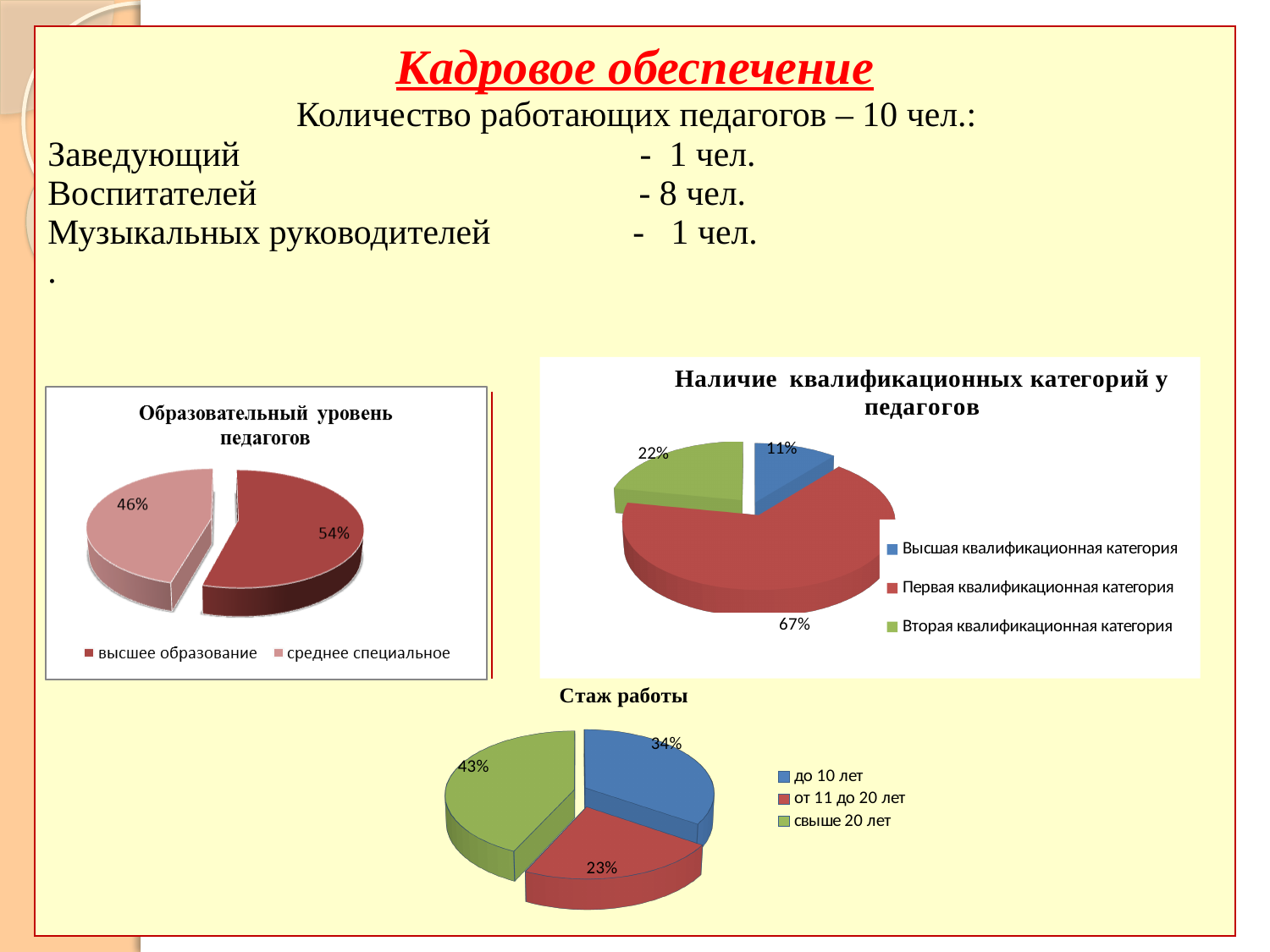
In the chart 'Наличие квалификационных категорий у педагогов', how many categories does the legend list? 3 In the chart 'Образовательный уровень педагогов', what share is labelled for 'высшее образование'? 54% In the chart 'Стаж работы', which category has the largest share? свыше 20 лет What kind of chart is 'Стаж работы'? pie chart In the chart 'Наличие квалификационных категорий у педагогов', what share is labelled for 'Первая квалификационная категория'? 67% In the chart 'Стаж работы', which is larger: the share for 'до 10 лет' or for 'от 11 до 20 лет'? до 10 лет In the chart 'Наличие квалификационных категорий у педагогов', which category has the smallest share? Высшая квалификационная категория In the chart 'Наличие квалификационных категорий у педагогов', what colour is the slice for 'Вторая квалификационная категория'? green In the chart 'Наличие квалификационных категорий у педагогов', what is the difference between the 'Вторая квалификационная категория' and 'Высшая квалификационная категория' shares? 11% In the chart 'Образовательный уровень педагогов', what share is labelled for 'среднее специальное'? 46% In the chart 'Образовательный уровень педагогов', what is the difference between the 'высшее образование' and 'среднее специальное' shares? 8% In the chart 'Стаж работы', what share is labelled for 'свыше 20 лет'? 43%